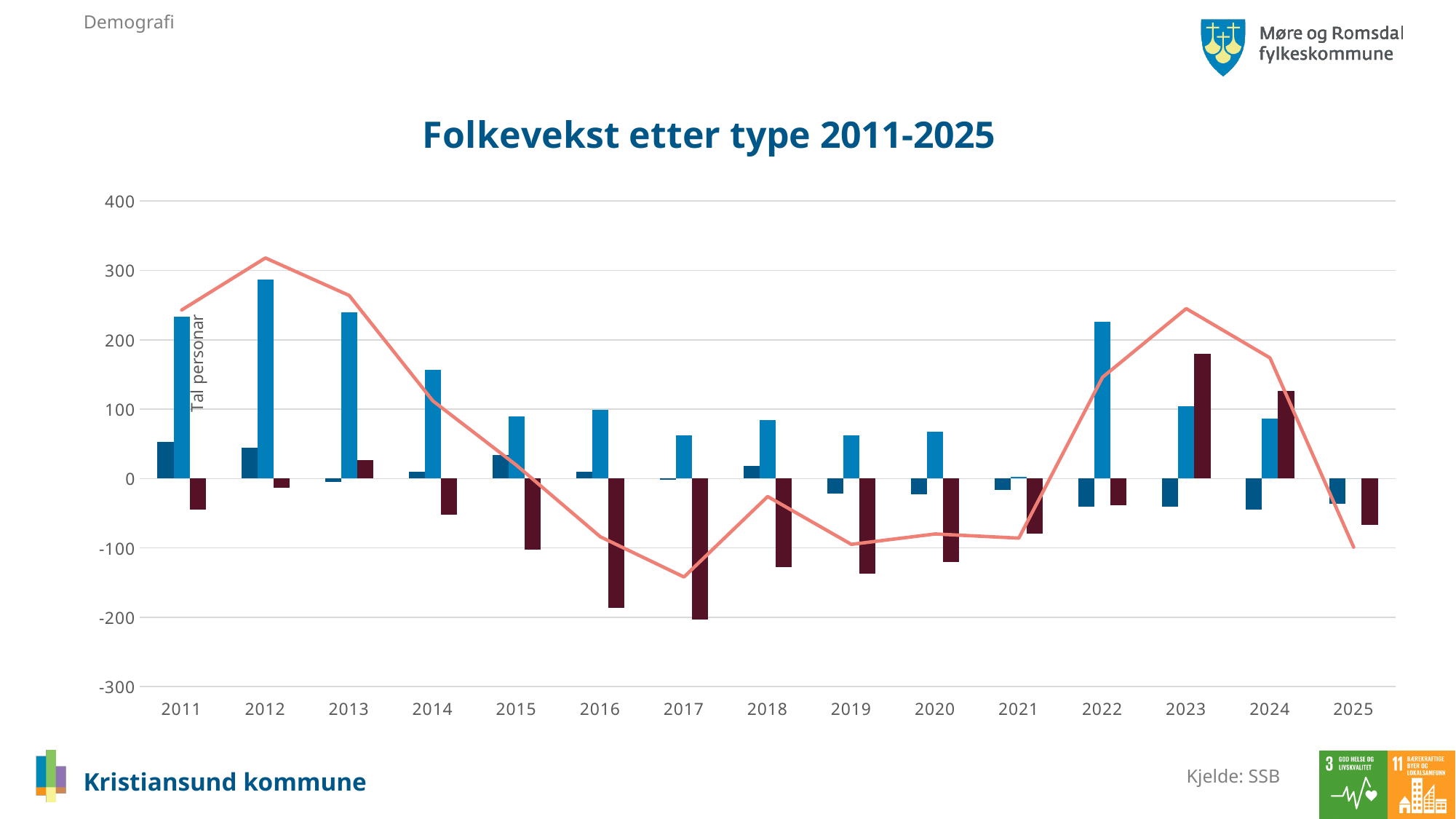
In which year is the dark red bar at its highest positive value? 2023 What is the label on the vertical axis of the chart? Tal personar In which year does the line reach its lowest value? 2017 Is the value of the line in 2017 greater or less than -100? less What is the title of the chart? Folkevekst etter type 2011-2025 What kind of chart is shown on the slide? bar chart with a line In which year does the line reach its highest value? 2012 Which year has the taller light blue bar, 2022 or 2023? 2022 How many years are shown along the x axis of the chart? 15 How many bars are plotted for each year in the chart? 3 In which year does the light blue bar reach its highest value? 2012 Is the value of the light blue bar in 2012 greater or less than 200? greater